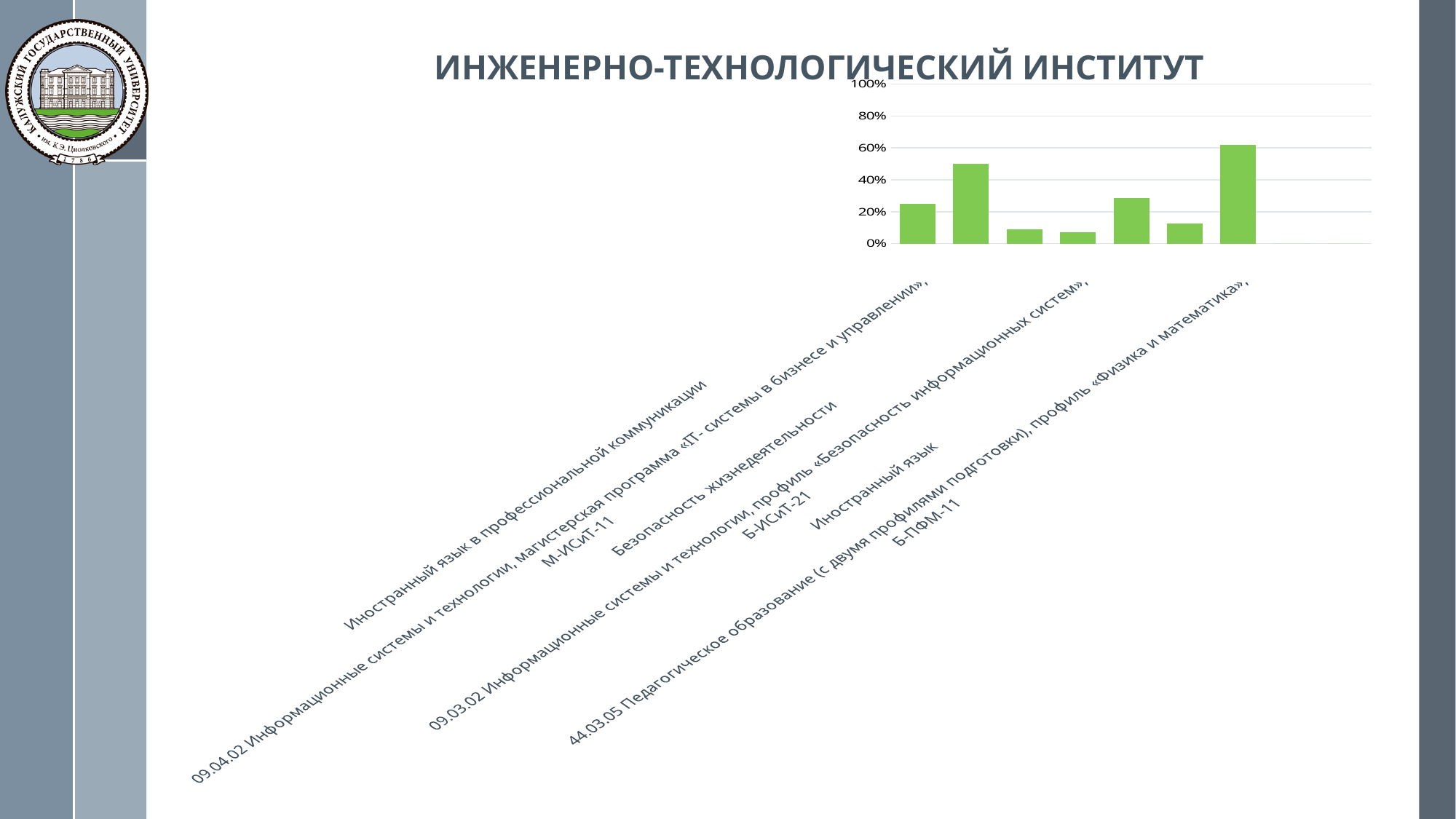
Is the value of the third bar from the left greater or less than 20%? less How many bars are plotted in the chart? 7 What is the highest value shown on the vertical axis? 100% Is the value of the sixth bar from the left greater or less than 20%? less What kind of chart is shown on the slide? bar chart Is the value of the second bar from the left greater or less than 40%? greater What colour are the bars in the chart? green Which is larger, the first bar or the second bar from the left? the second bar Which bar is the tallest in the chart? the rightmost (seventh) bar Which is larger, the fifth bar or the sixth bar from the left? the fifth bar